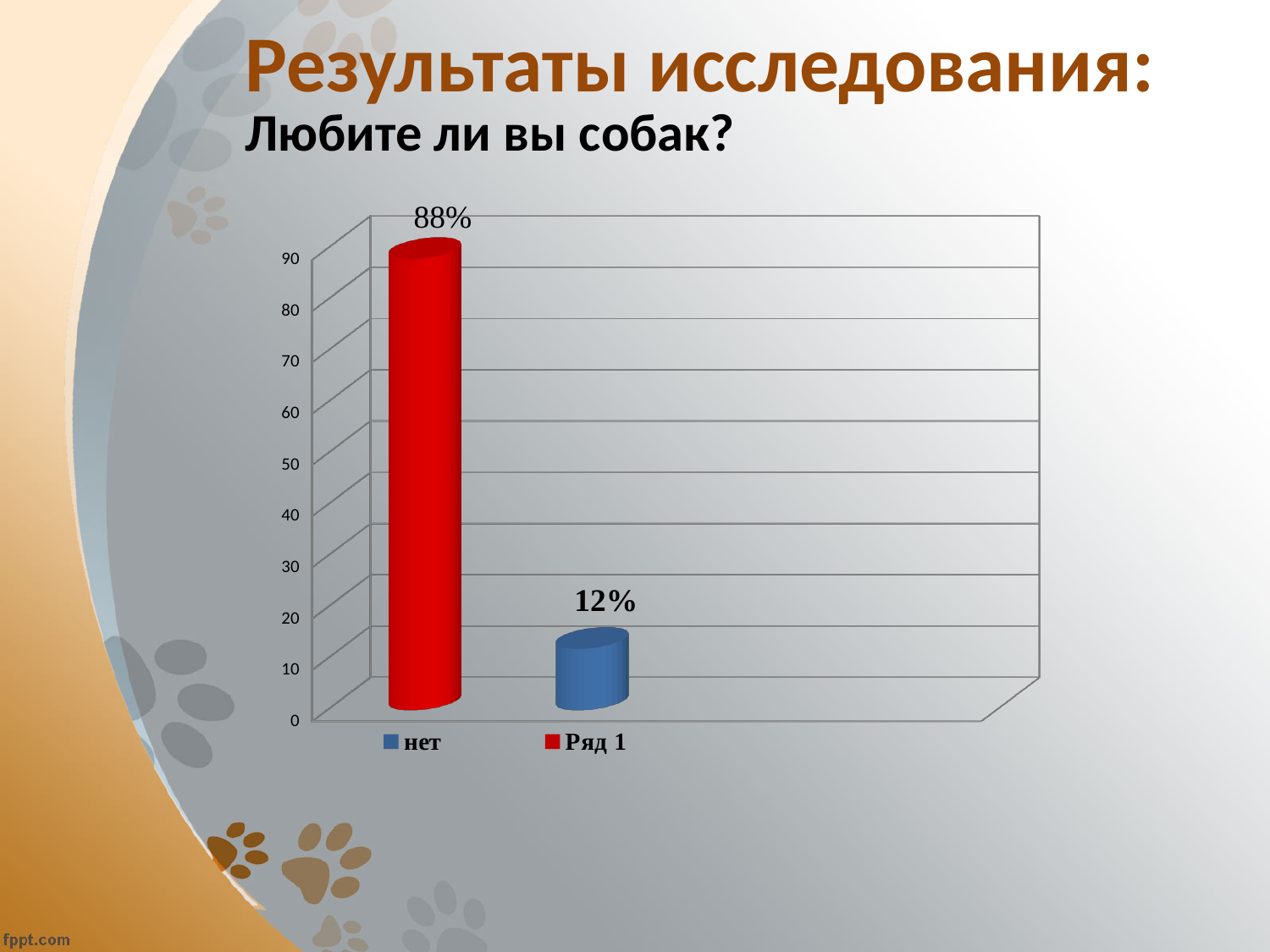
What value is shown on the red bar (Ряд 1)? 88% What value is shown on the blue bar (нет)? 12% How many entries does the legend list? 2 What colour is the bar for Ряд 1? red What kind of chart is shown on the slide? bar chart What is the difference between the values of Ряд 1 and нет? 76% How many bars are plotted in the chart? 2 Is the value for нет greater or less than 20? less Which legend entry has the highest value? Ряд 1 Is the value for Ряд 1 greater or less than 80? greater Which is larger, the value for Ряд 1 or the value for нет? Ряд 1 Which legend entry has the lowest value? нет